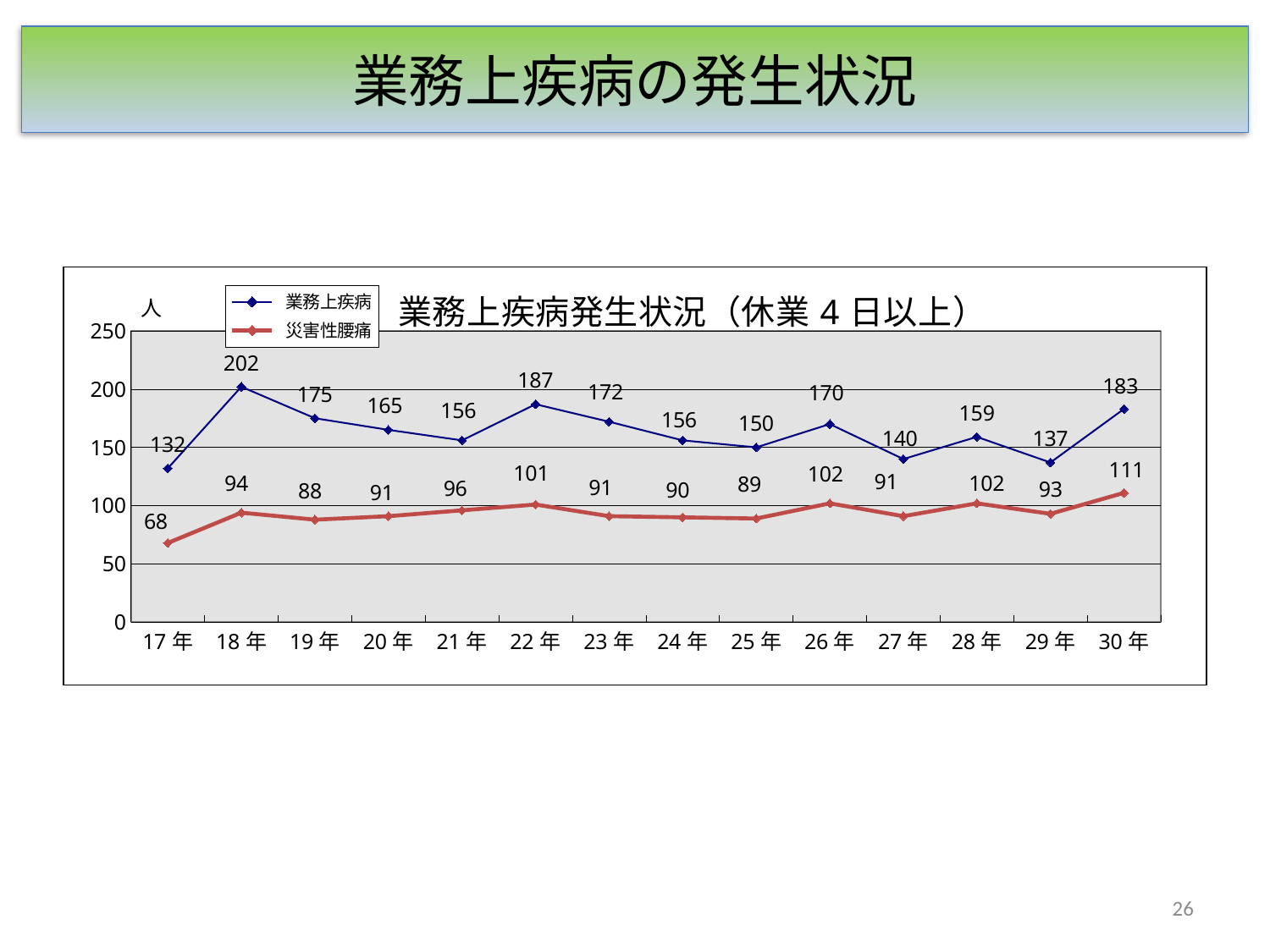
What is the difference between 業務上疾病 and 災害性腰痛 in 22年? 86 What is the value of 災害性腰痛 in 30年? 111 In which year is 業務上疾病 highest? 18年 How many series does the legend list? 2 How many years are shown on the x axis? 14 Does 業務上疾病 rise or fall from 28年 to 29年? fall Which is larger: 業務上疾病 in 26年 or 業務上疾病 in 27年? 26年 What is the value of 業務上疾病 in 18年? 202 In which year is 災害性腰痛 lowest? 17年 Is the value of 業務上疾病 in 17年 greater or less than 150? less What is the title of the chart? 業務上疾病発生状況（休業４日以上） What kind of chart is shown? line chart